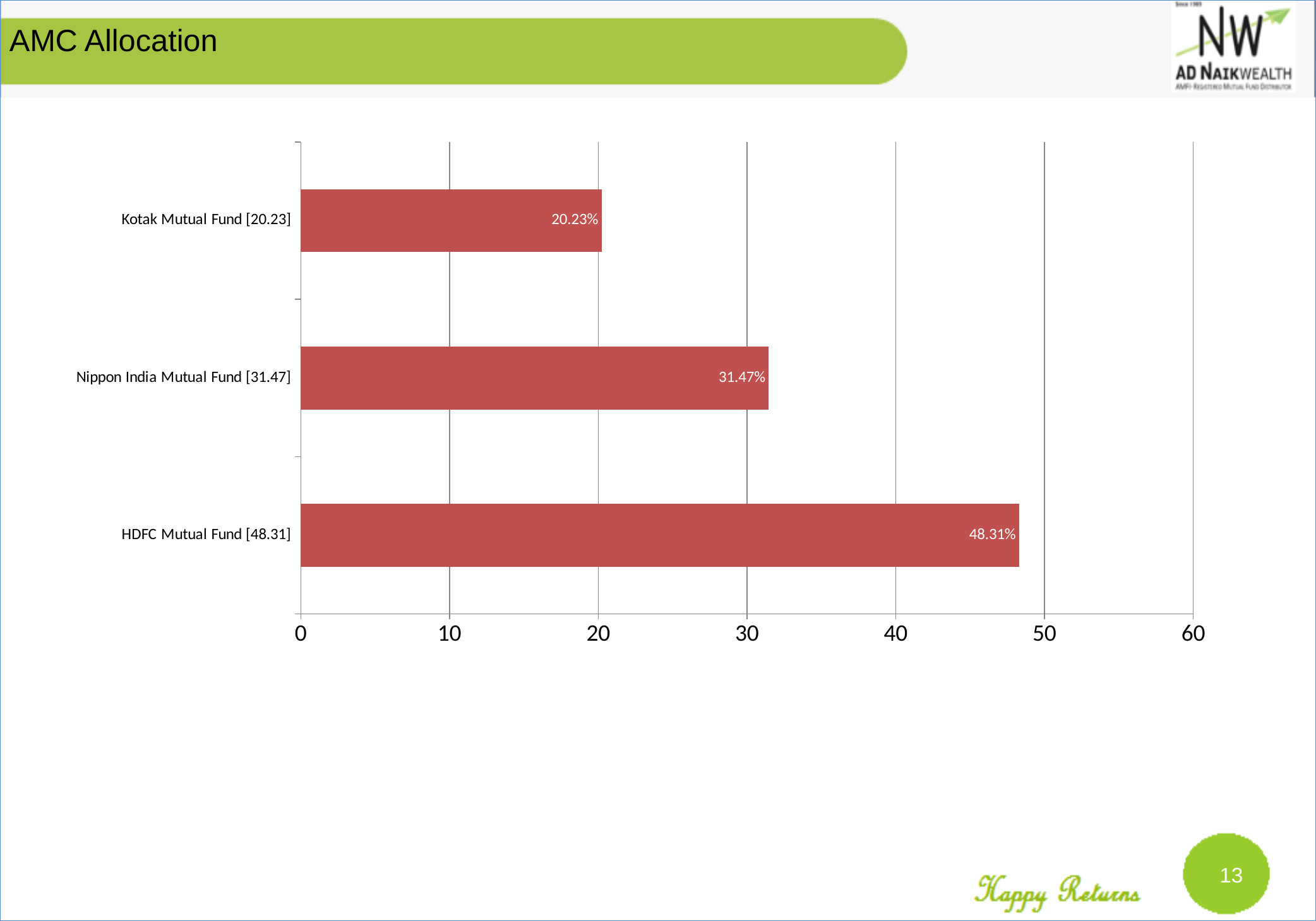
What is the difference between the Nippon India Mutual Fund and Kotak Mutual Fund values? 11.24% How many funds are shown in the chart? 3 Which fund has the highest allocation? HDFC Mutual Fund Is the value for HDFC Mutual Fund greater or less than 40? greater What is the difference between the HDFC Mutual Fund and Kotak Mutual Fund values? 28.08% What is the value for HDFC Mutual Fund? 48.31% What is the value for Kotak Mutual Fund? 20.23% What is the value for Nippon India Mutual Fund? 31.47% Which fund has the lowest allocation? Kotak Mutual Fund What is the title of the slide? AMC Allocation What kind of chart is shown on the slide? bar chart Which is larger, the value for Nippon India Mutual Fund or Kotak Mutual Fund? Nippon India Mutual Fund